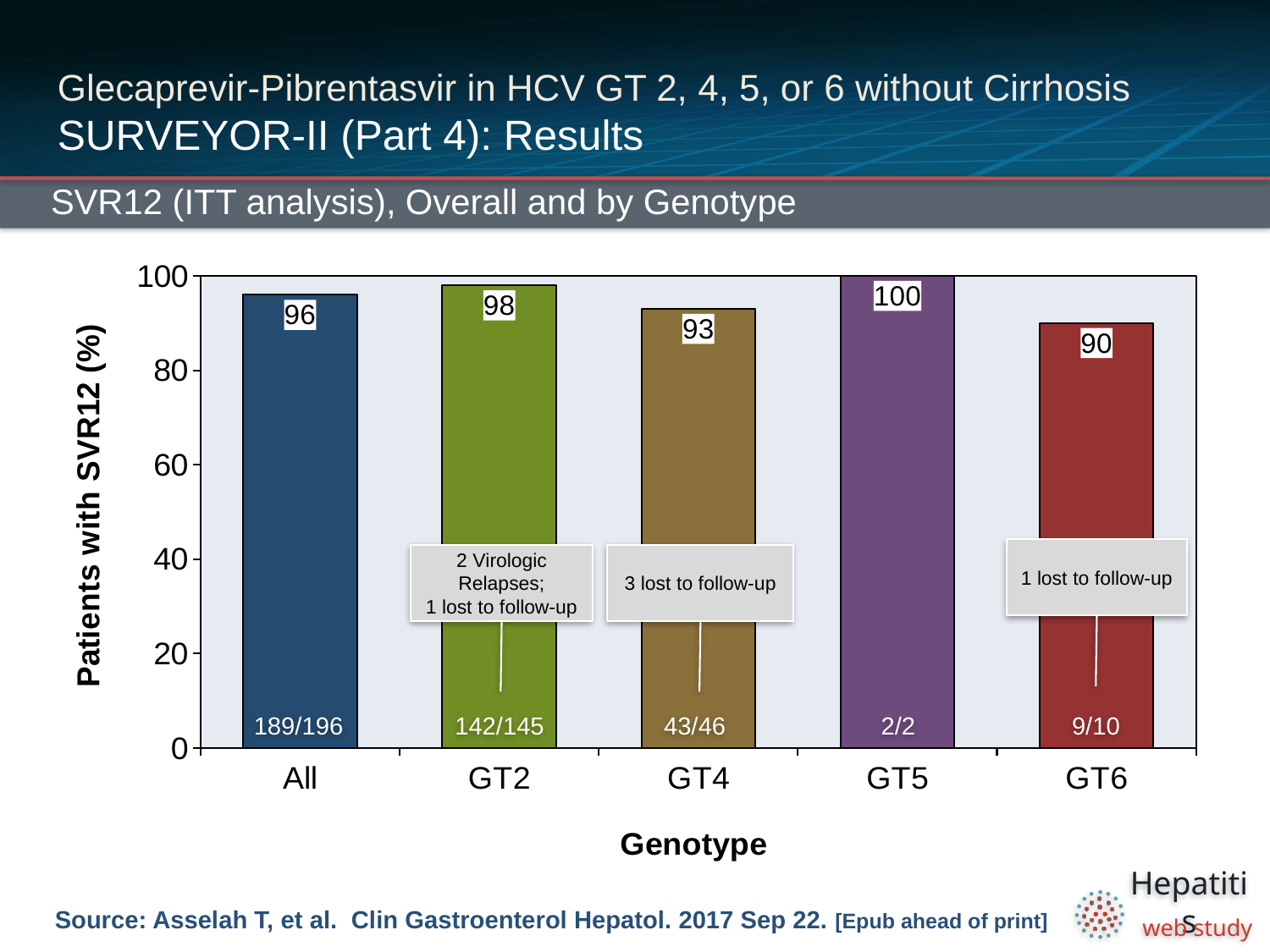
What is the SVR12 value for the All group? 96 What is the label of the y axis? Patients with SVR12 (%) Which has a higher SVR12 value, GT2 or GT4? GT2 Which genotype category has the highest SVR12 value? GT5 What is the difference between the SVR12 values for GT2 and GT6? 8 How many categories are shown on the x axis? 5 What fraction of patients is printed at the bottom of the GT2 bar? 142/145 Which genotype category has the lowest SVR12 value? GT6 Is the value for GT6 greater or less than 80? greater What is the SVR12 value for GT4? 93 What is the SVR12 value for GT6? 90 What kind of chart is shown on the slide? Bar chart